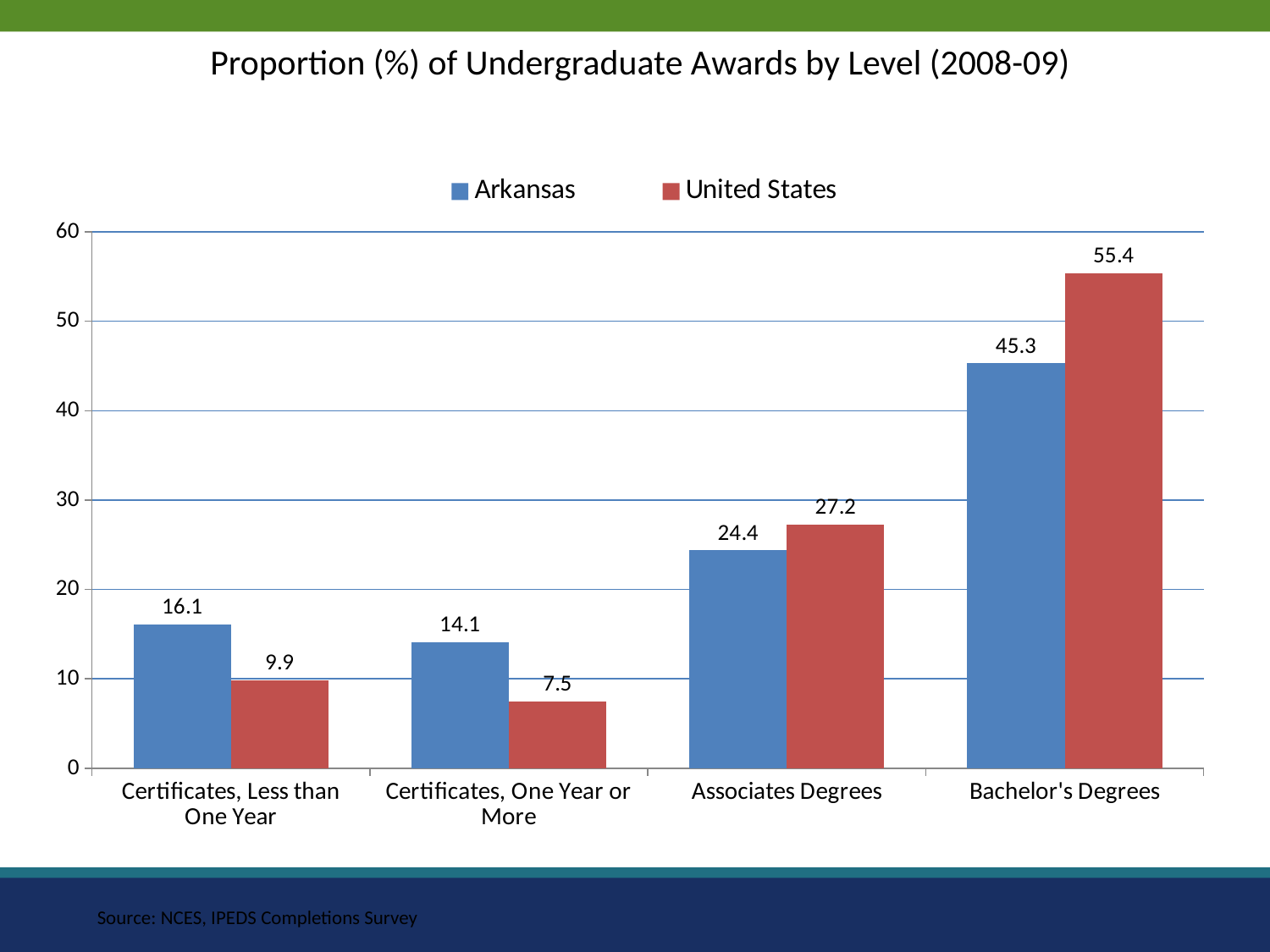
What is the difference between the United States and Arkansas values for Bachelor's Degrees? 10.1 What is the United States value for Certificates, One Year or More? 7.5 How many series does the legend list? 2 Which category has the highest Arkansas value? Bachelor's Degrees For Associates Degrees, which is larger: Arkansas or United States? United States What kind of chart is shown on the slide? Bar chart What is the difference between the Arkansas and United States values for Certificates, Less than One Year? 6.2 What is the Arkansas value for Associates Degrees? 24.4 Is the Arkansas value for Bachelor's Degrees greater or less than 40? greater How many categories are shown on the x axis? 4 What is the United States value for Bachelor's Degrees? 55.4 Which category has the lowest United States value? Certificates, One Year or More